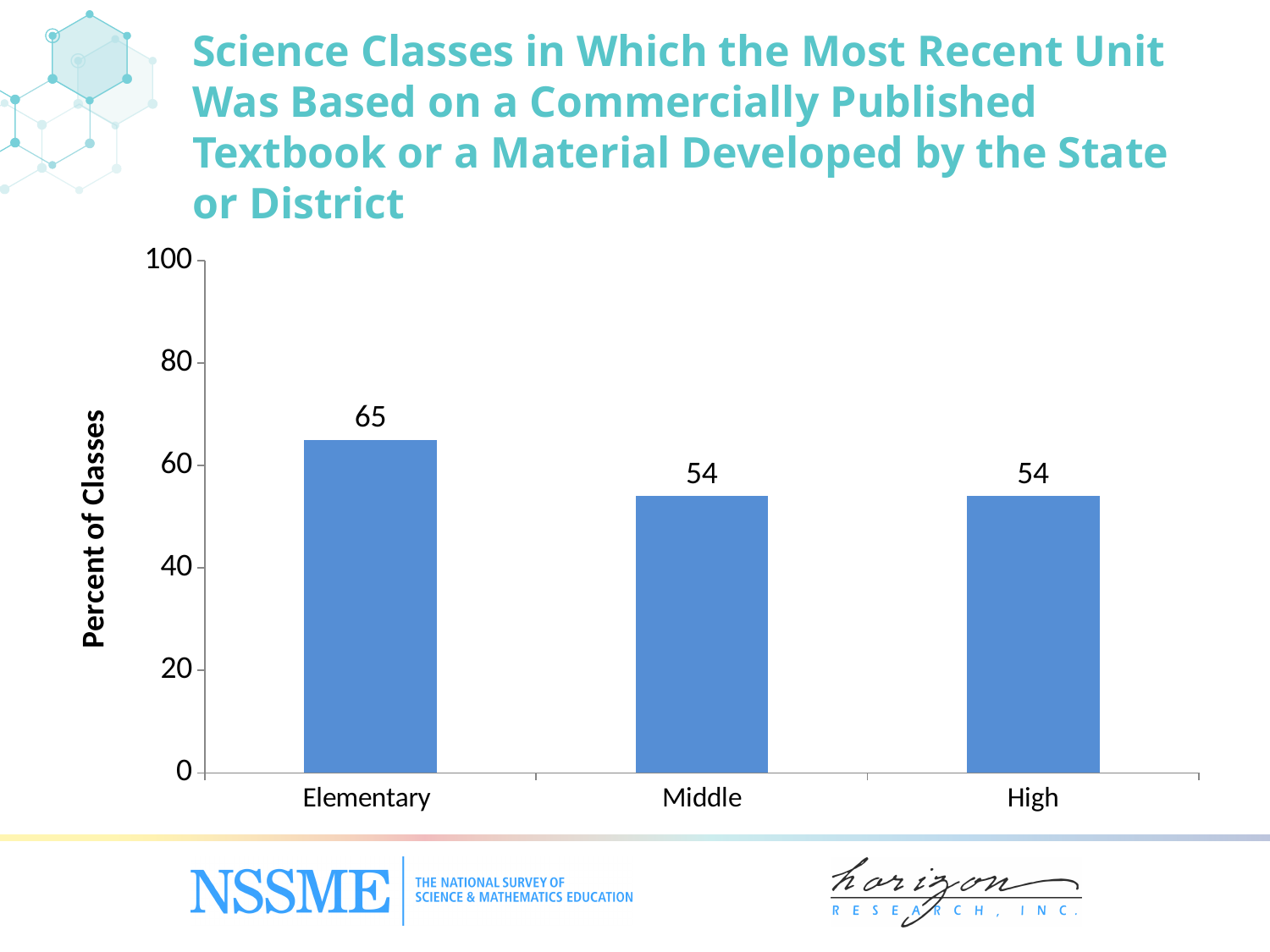
Is the value for Elementary greater or less than 60? greater How many categories are shown on the x axis? 3 What kind of chart is shown on the slide? bar chart Which is larger, the value for Elementary or the value for High? Elementary Do the values for Middle and High differ? No, both are 54 Which category has the highest value? Elementary Is the value for Middle greater or less than 60? less What is the value for Middle? 54 What is the label of the y axis? Percent of Classes What is the value for Elementary? 65 What is the value for High? 54 What is the difference between the values for Elementary and Middle? 11